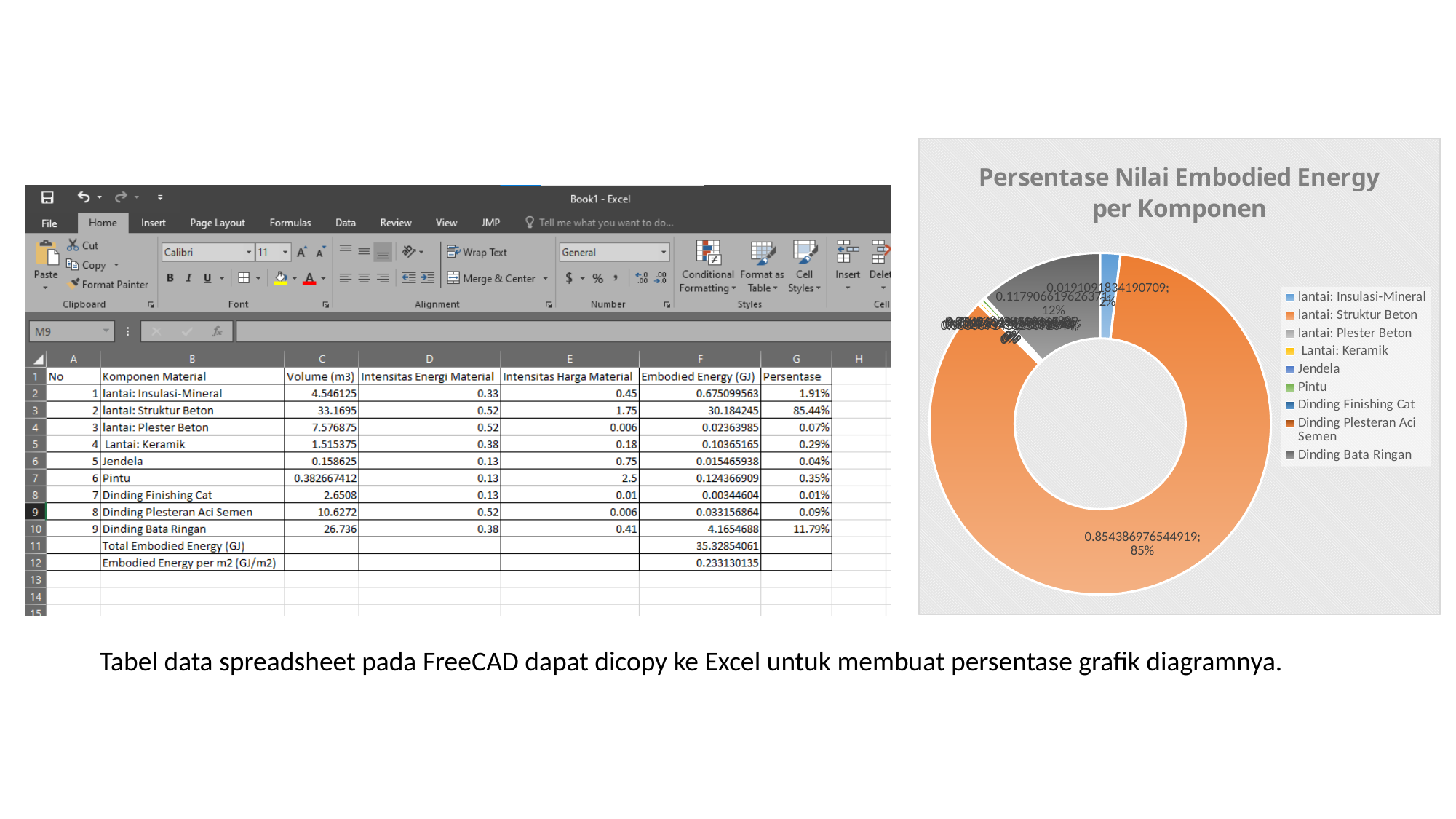
How many entries does the legend of the chart list? 9 Is the share for lantai: Struktur Beton greater or less than 50%? greater What colour is the largest slice of the chart? orange Which slice is larger in the chart, Dinding Bata Ringan or lantai: Insulasi-Mineral? Dinding Bata Ringan Which component has the largest slice in the chart? lantai: Struktur Beton What is the title of the chart on the slide? Persentase Nilai Embodied Energy per Komponen What percentage share is labelled for lantai: Struktur Beton in the chart? 85% What percentage share is labelled for Dinding Bata Ringan in the chart? 12% What is the difference in percentage points between the lantai: Struktur Beton slice and the Dinding Bata Ringan slice? 73% What kind of chart is shown on the right side of the slide? doughnut chart What is the difference in percentage points between the Dinding Bata Ringan slice and the lantai: Insulasi-Mineral slice? 10% What percentage share is labelled for lantai: Insulasi-Mineral in the chart? 2%